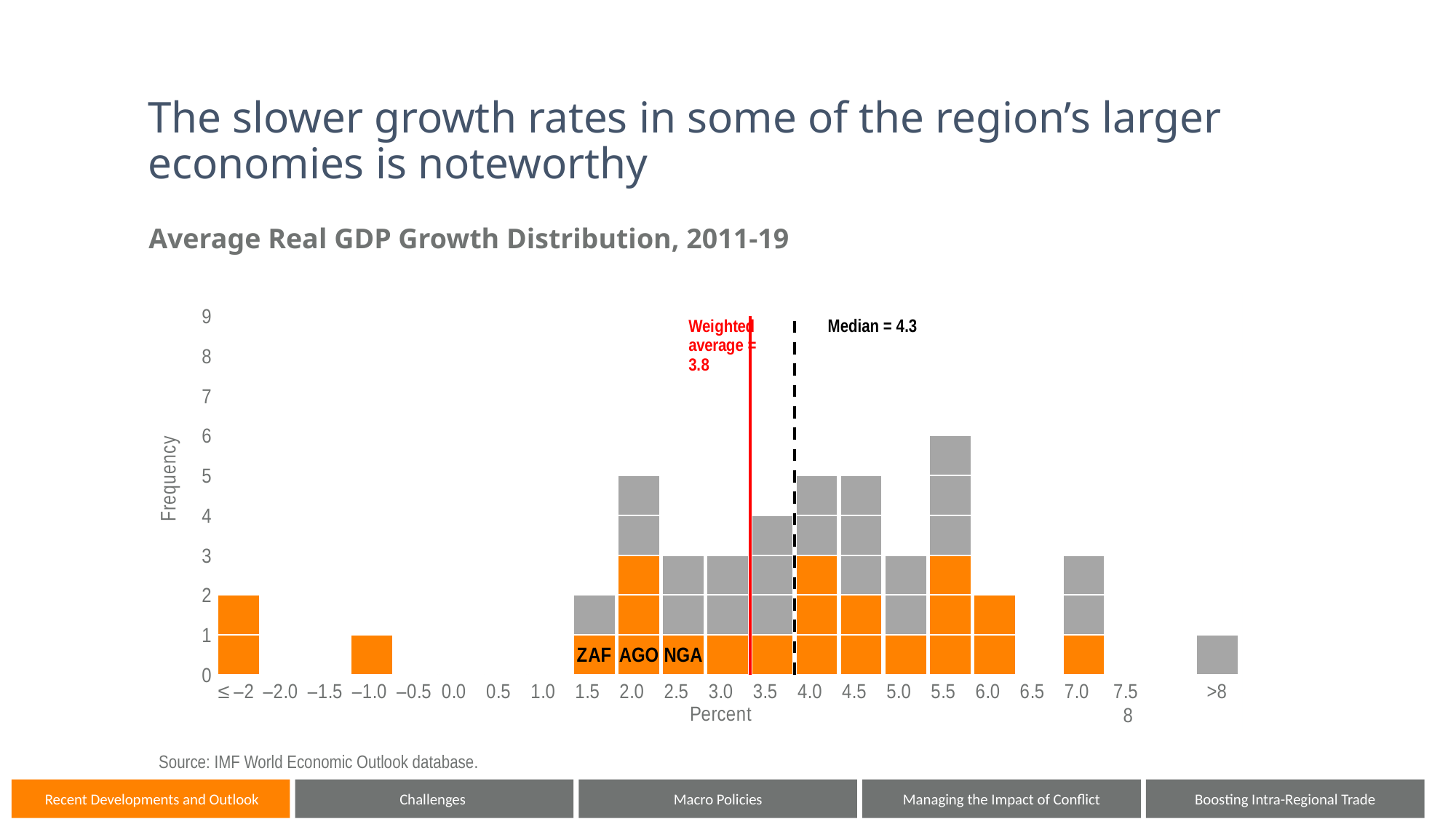
What is the frequency for the 5.5 percent bin? 6 Which percent bin has the highest frequency? 5.5 What is the frequency for the ≤ −2 percent bin? 2 What is the difference in frequency between the 5.5 bin and the 3.5 bin? 2 What is the frequency for the 2.0 percent bin? 5 What kind of chart is shown on the slide? bar chart What is the frequency for the >8 percent bin? 1 Which has a higher frequency, the 4.0 bin or the 5.0 bin? 4.0 Which percent bin is labelled ZAF? 1.5 What is the weighted average value marked on the chart? 3.8 What is the median value marked on the chart? 4.3 What is the title of the chart? Average Real GDP Growth Distribution, 2011-19